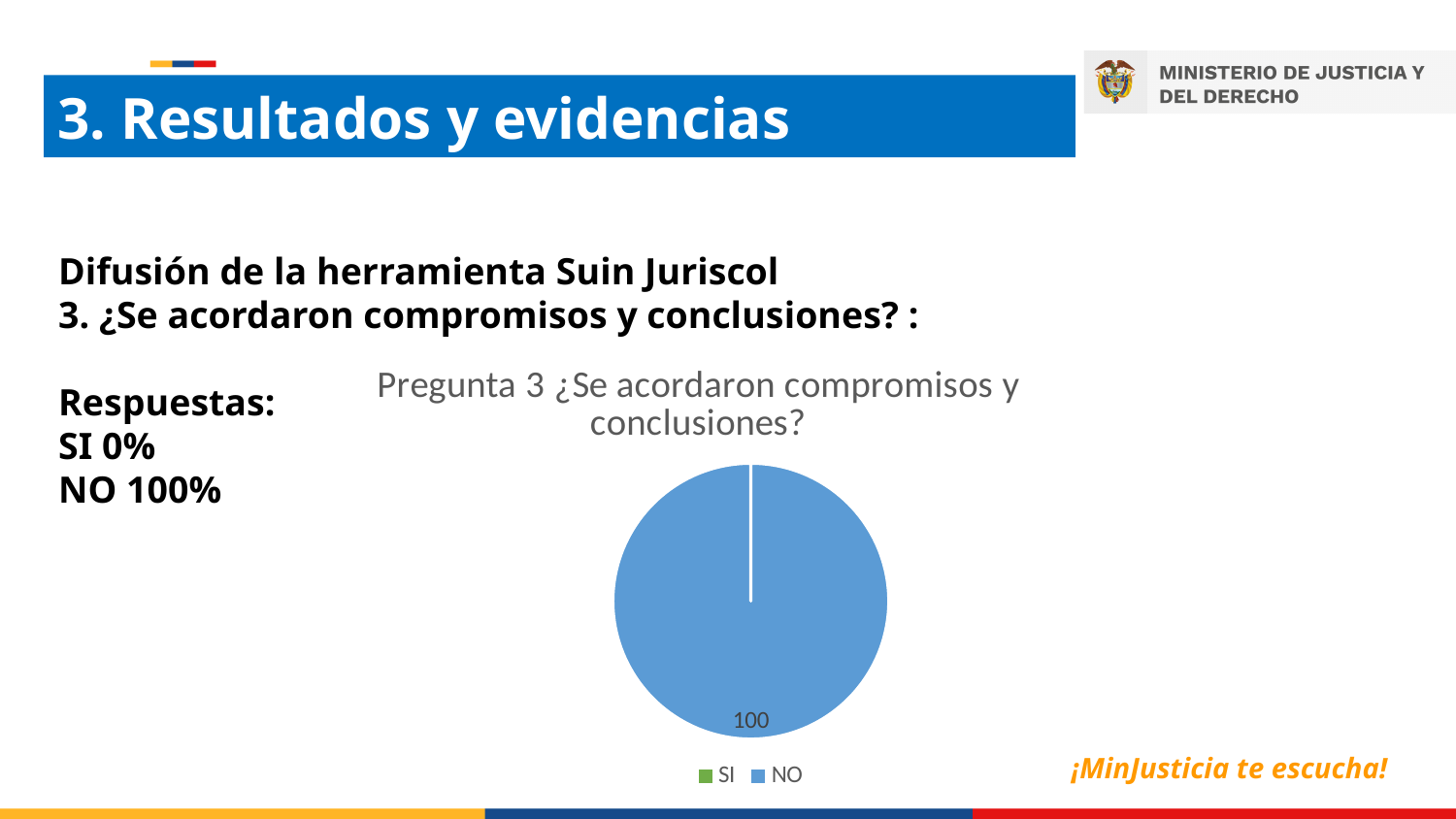
Which category takes the largest share of the pie? NO How many categories are listed in the legend of the pie chart? 2 What is the title of the chart? Pregunta 3 ¿Se acordaron compromisos y conclusiones? What value is printed on the pie for NO? 100 How many entries does the chart legend list? 2 Which is larger, the share for SI or the share for NO? NO What kind of chart is shown on the slide? pie chart What colour represents NO in the legend? blue Which category takes the smallest share of the pie? SI What share of the pie does NO represent? 100